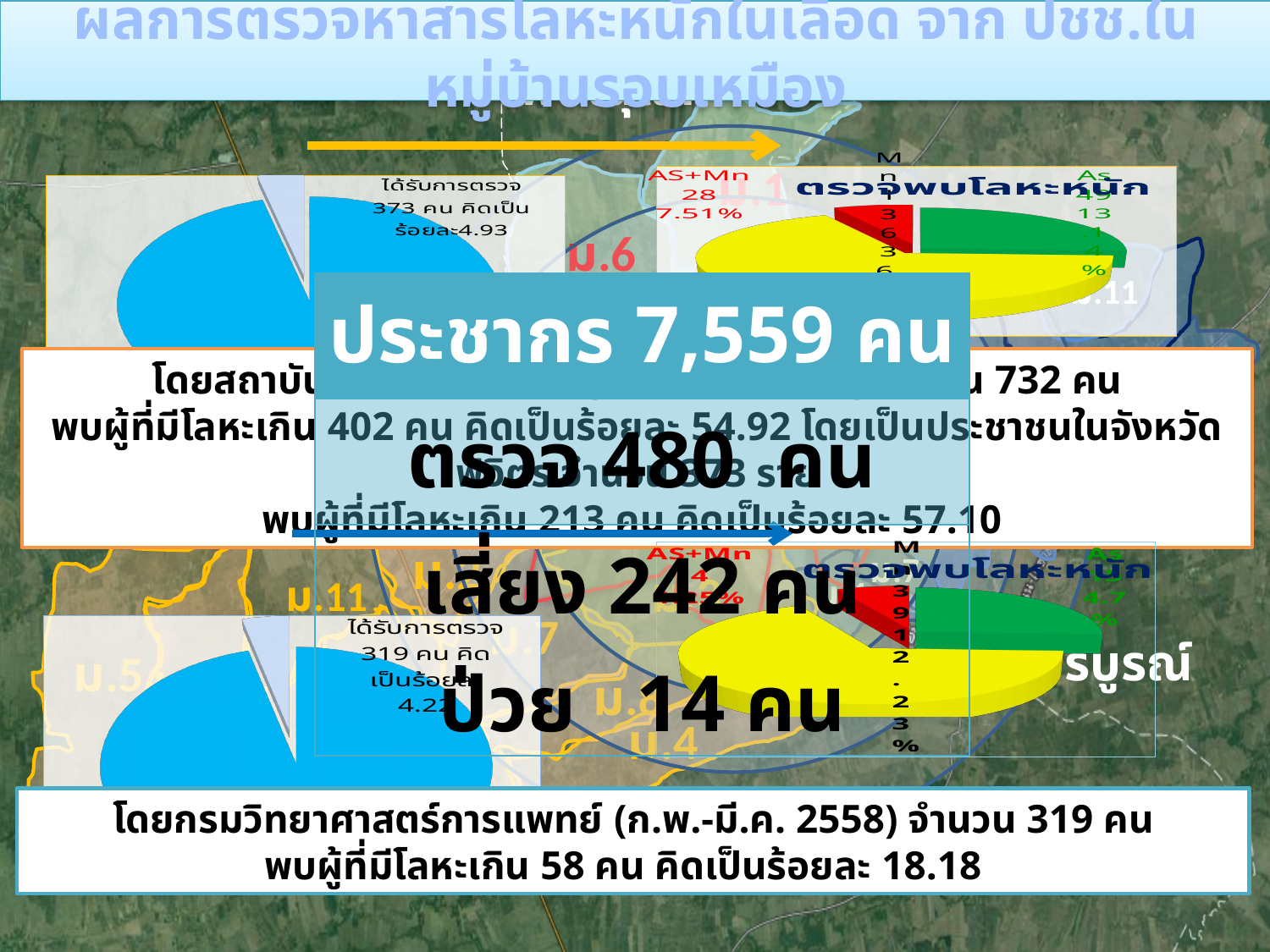
In the top-right pie chart (ตรวจพบโลหะหนัก), what colour is the AS+Mn slice? red How many slices does the top-right pie chart (ตรวจพบโลหะหนัก) have? 3 In the bottom-right pie chart (ตรวจพบโลหะหนัก), which has the larger count, Mn or As? Mn In the bottom-left pie chart, what percentage (ร้อยละ) is shown in its label? 4.22 In the top-left pie chart, what percentage (ร้อยละ) is shown in its label? 4.93 In the top-right pie chart (ตรวจพบโลหะหนัก), what is the count shown for AS+Mn? 28 In the bottom-right pie chart (ตรวจพบโลหะหนัก), what percentage is shown for Mn? 12.23% In the top-left pie chart, how many people were tested (ได้รับการตรวจ) according to its label? 373 คน In the top-right pie chart (ตรวจพบโลหะหนัก), what percentage is shown for AS+Mn? 7.51% What kind of chart is the top-left chart on the slide? pie chart In the bottom-left pie chart, how many people were tested (ได้รับการตรวจ) according to its label? 319 คน